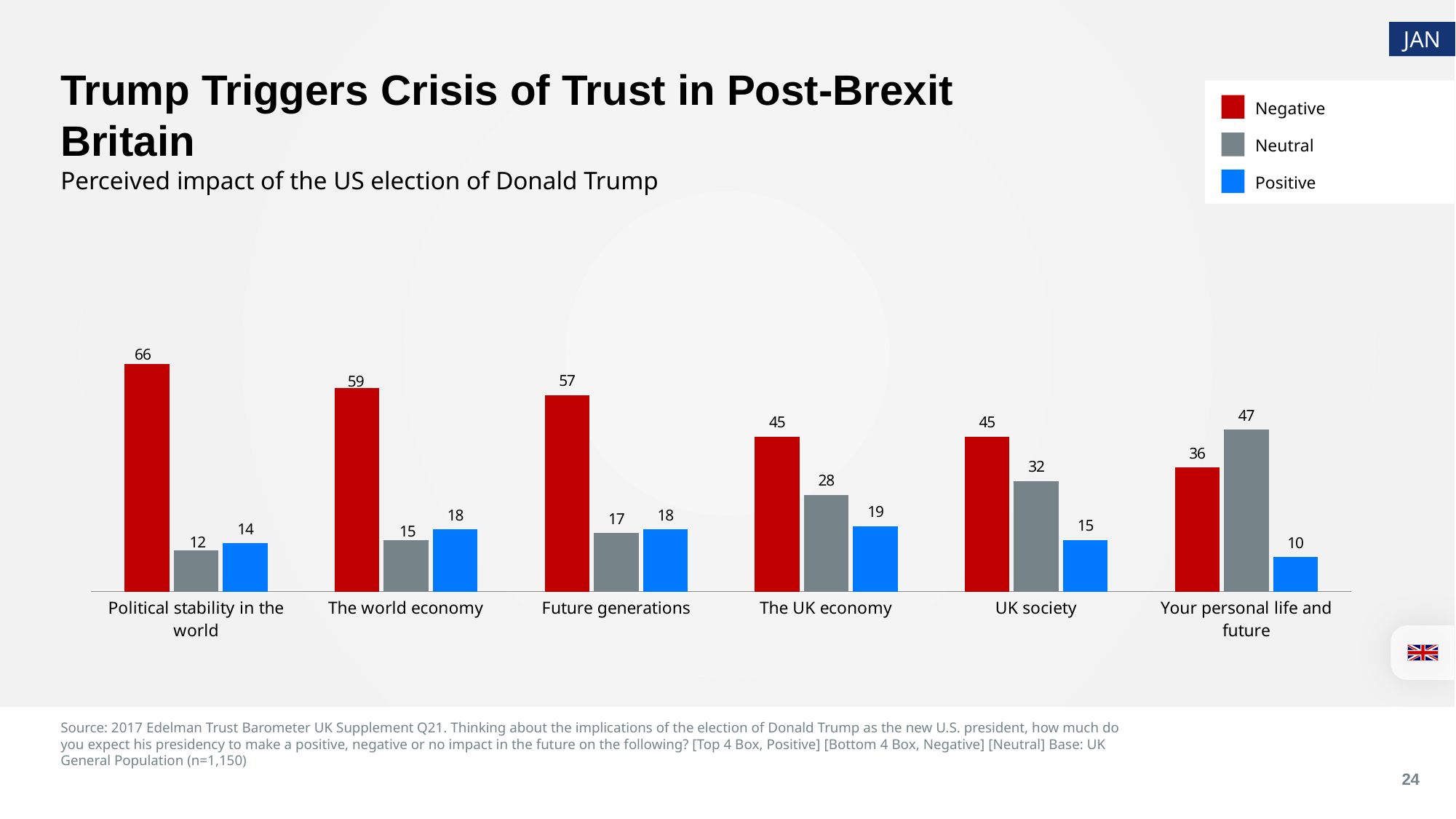
Do the Negative values rise or fall from left to right across the categories? Fall What kind of chart is shown on the slide? Bar chart What is the difference between the Negative and Positive values for The world economy? 41 How many categories are shown on the x axis? 6 Which category has the lowest Positive value? Your personal life and future Which category has the highest Negative value? Political stability in the world What is the Positive value for The UK economy? 19 How many series does the legend list? 3 What is the Negative value for Political stability in the world? 66 What is the Neutral value for Your personal life and future? 47 Which colour represents the Neutral series in the legend? Grey Which is larger for Your personal life and future, the Negative value or the Neutral value? Neutral